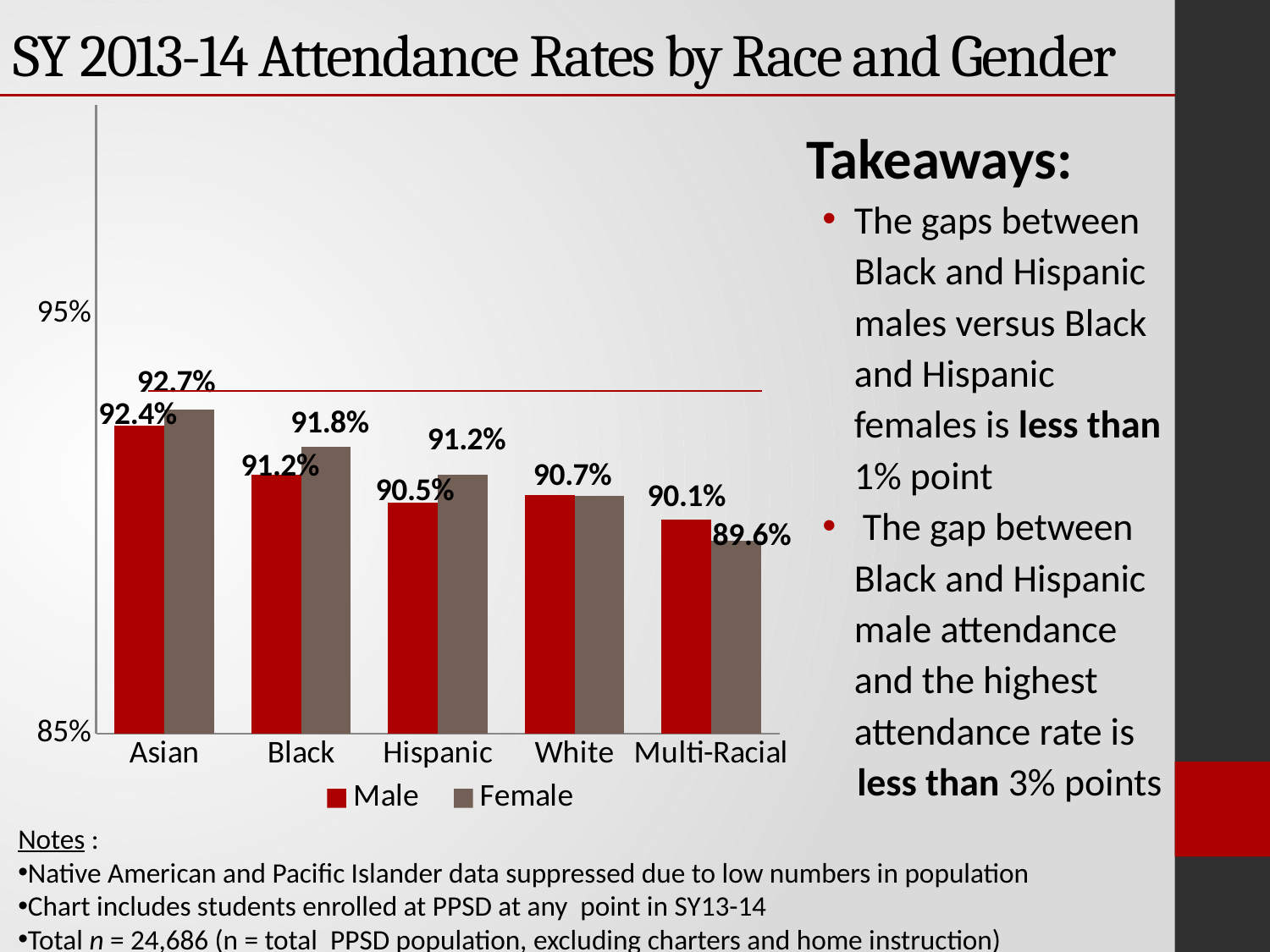
What is the attendance rate for Black males? 91.2% For Hispanic students, which is higher: the male or the female attendance rate? Female Is the attendance rate for Multi-Racial females greater or less than 90%? less What is the attendance rate for Hispanic females? 91.2% What is the attendance rate for Multi-Racial females? 89.6% How many race categories are shown on the x axis? 5 What type of chart is shown on the slide? Bar chart How many series does the legend list? 2 Which race category has the highest male attendance rate? Asian Which race category has the lowest female attendance rate? Multi-Racial What is the difference between the Black female and Black male attendance rates? 0.6% What is the attendance rate for Asian females? 92.7%